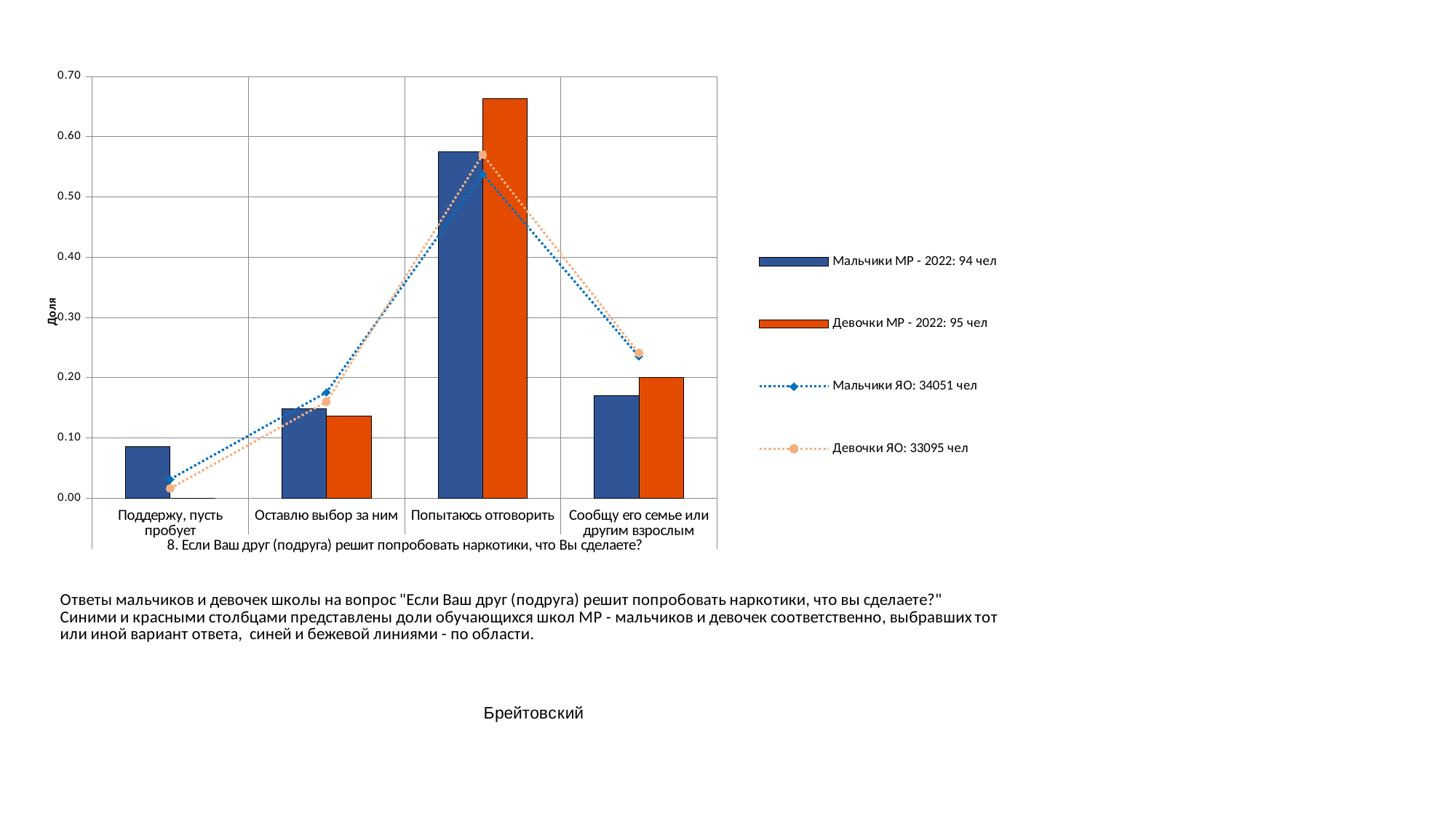
What kind of chart is shown on the slide? bar and line chart How many series does the legend list? 4 For the series Девочки МР - 2022, which category has the highest value? Попытаюсь отговорить Is the value for Мальчики ЯО in the category Сообщу его семье или другим взрослым greater or less than 0.20? greater Is the value for Девочки МР - 2022 in the category Попытаюсь отговорить greater or less than 0.60? greater Is the value for Мальчики МР - 2022 in the category Поддержу, пусть пробует greater or less than 0.10? less In the category Попытаюсь отговорить, which is larger: Мальчики МР - 2022 or Девочки МР - 2022? Девочки МР - 2022 How many answer categories are shown on the x axis? 4 For the series Мальчики МР - 2022, which category has the lowest value? Поддержу, пусть пробует In the category Сообщу его семье или другим взрослым, which is larger: Мальчики МР - 2022 or Девочки МР - 2022? Девочки МР - 2022 What is the title of the y axis? Доля